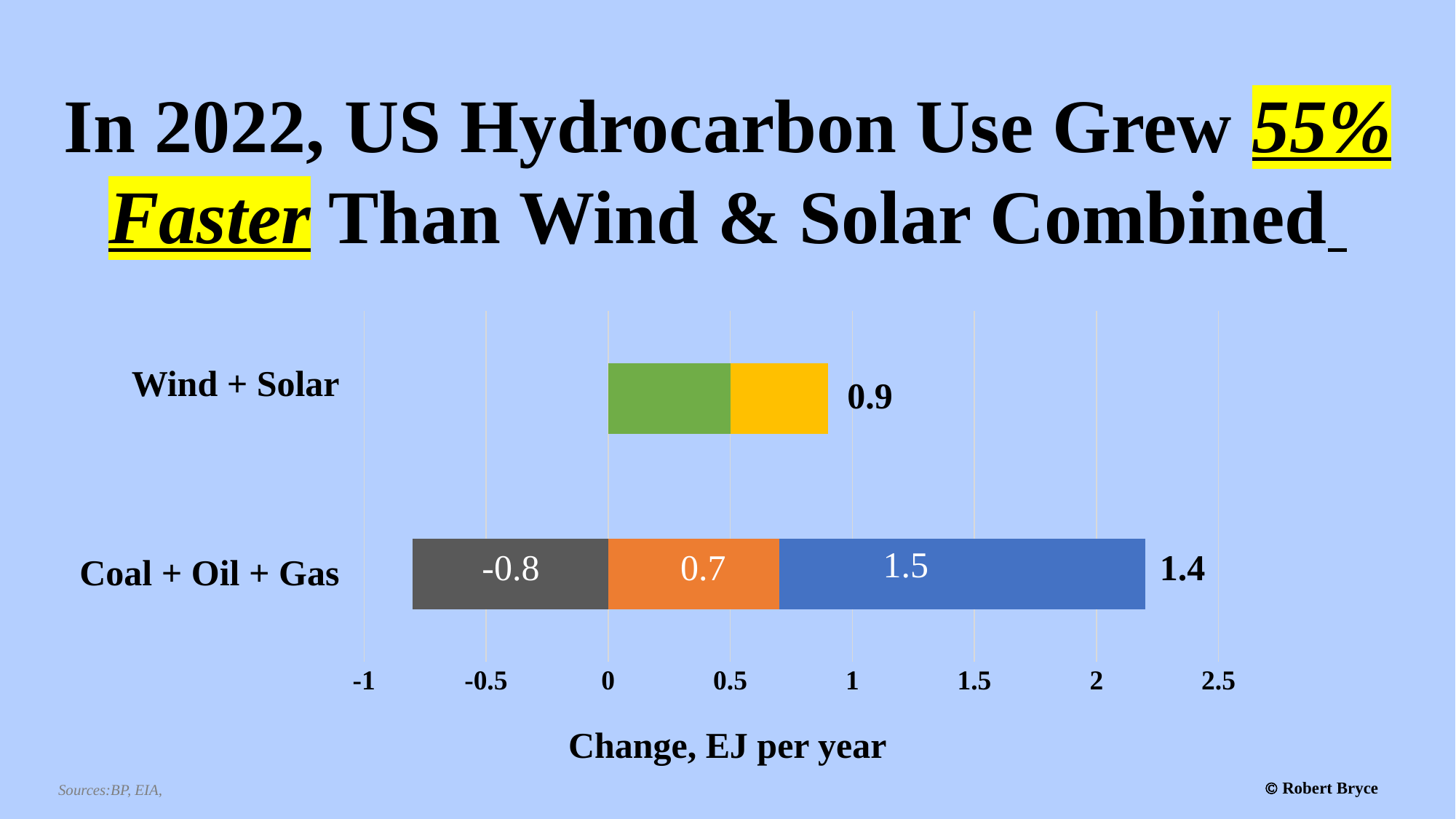
How many categories are shown on the chart? 2 Which segment of the Coal + Oil + Gas bar has the lowest value? -0.8 (grey segment) What value is printed on the blue segment of the Coal + Oil + Gas bar? 1.5 What value is printed on the grey segment of the Coal + Oil + Gas bar? -0.8 What is the total value shown for the Wind + Solar bar? 0.9 Which category has the higher total value, Wind + Solar or Coal + Oil + Gas? Coal + Oil + Gas What is the title of the x axis? Change, EJ per year What is the difference between the total for Coal + Oil + Gas and the total for Wind + Solar? 0.5 What kind of chart is shown on the slide? Stacked bar chart What is the total value shown for the Coal + Oil + Gas bar? 1.4 What value is printed on the orange segment of the Coal + Oil + Gas bar? 0.7 Which segment of the Coal + Oil + Gas bar has the largest value? 1.5 (blue segment)